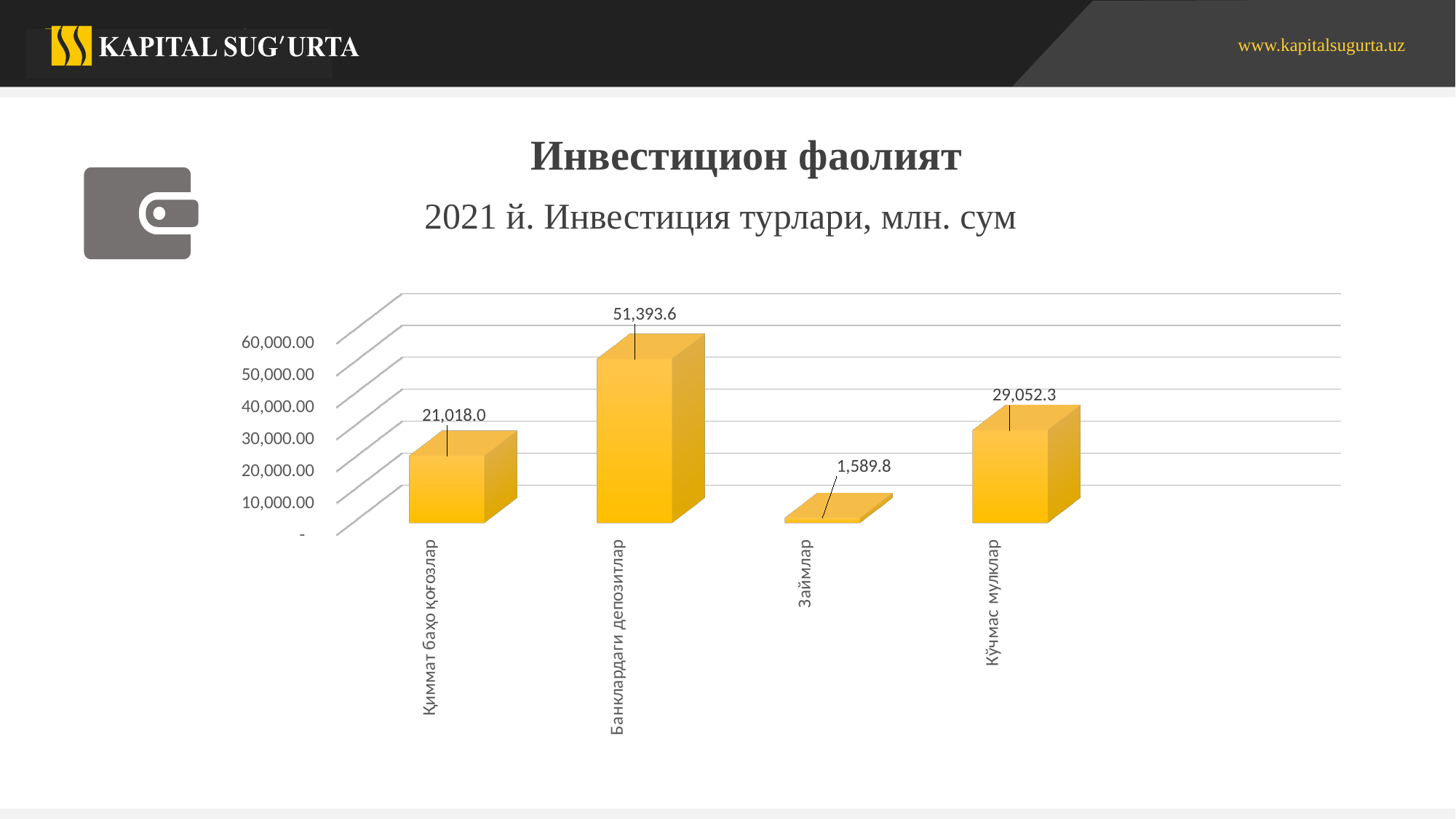
What is the subtitle of the chart? 2021 й. Инвестиция турлари, млн. сум Which category has the lowest value? Займлар What kind of chart is shown on the slide? Bar chart Which is larger, the value for Қиммат баҳо қоғозлар or the value for Кўчмас мулклар? Кўчмас мулклар What is the value for Займлар? 1,589.8 How many categories are shown in the chart? 4 What is the value for Банклардаги депозитлар? 51,393.6 What is the value for Кўчмас мулклар? 29,052.3 What is the value for Қиммат баҳо қоғозлар? 21,018.0 What is the difference between the values for Банклардаги депозитлар and Кўчмас мулклар? 22,341.3 What is the difference between the values for Кўчмас мулклар and Қиммат баҳо қоғозлар? 8,034.3 Which category has the highest value? Банклардаги депозитлар